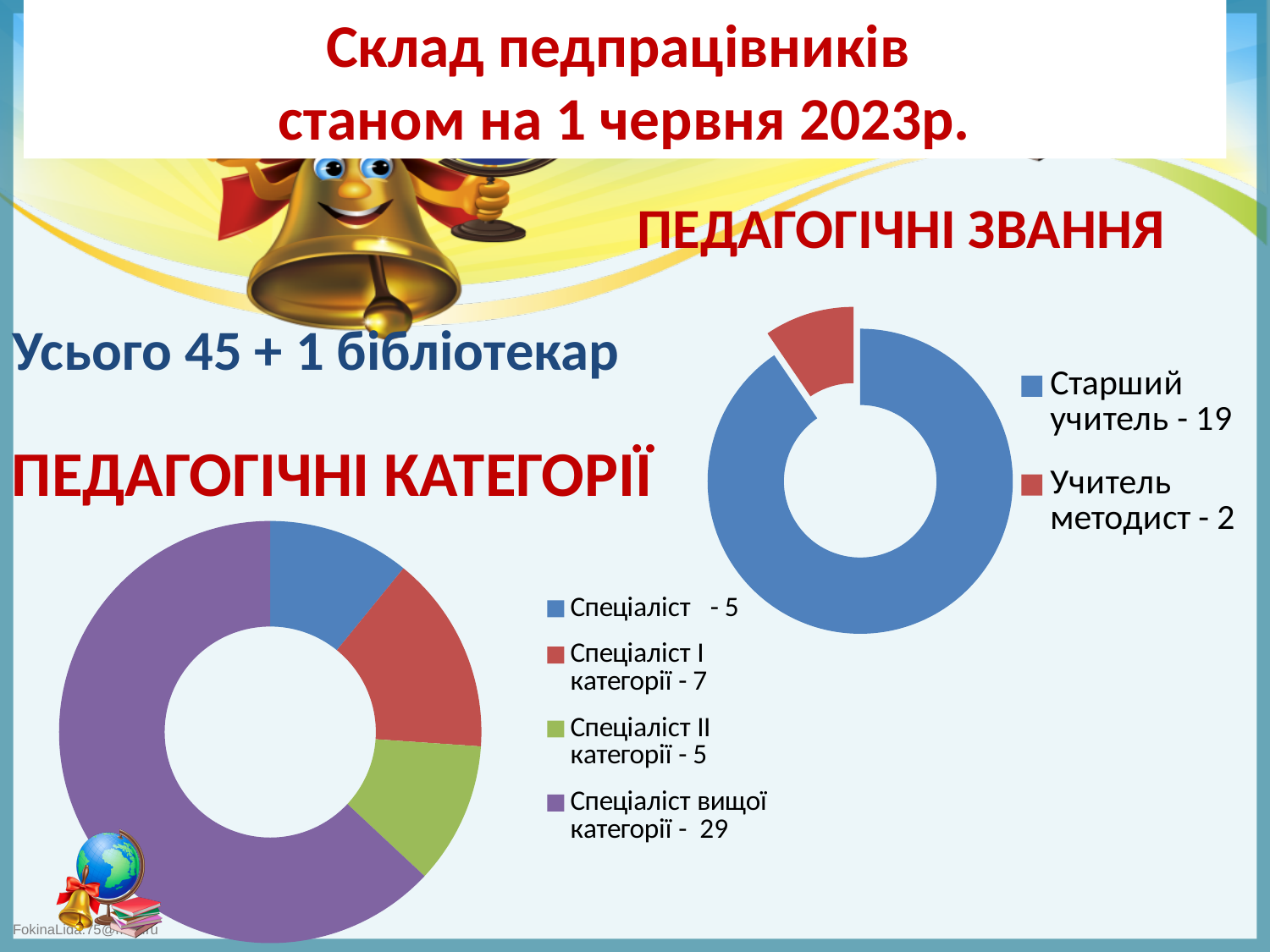
In the 'ПЕДАГОГІЧНІ КАТЕГОРІЇ' chart, what is the difference between 'Спеціаліст вищої категорії' and 'Спеціаліст І категорії'? 22 In the 'ПЕДАГОГІЧНІ КАТЕГОРІЇ' chart, what colour represents 'Спеціаліст вищої категорії'? Purple In the 'ПЕДАГОГІЧНІ ЗВАННЯ' chart on the right, how many teachers are 'Старший учитель'? 19 In the 'ПЕДАГОГІЧНІ КАТЕГОРІЇ' chart, which is larger: 'Спеціаліст І категорії' or 'Спеціаліст ІІ категорії'? Спеціаліст І категорії What kind of chart is the 'ПЕДАГОГІЧНІ КАТЕГОРІЇ' chart on the left of the slide? Doughnut chart In the 'ПЕДАГОГІЧНІ КАТЕГОРІЇ' chart, how many teachers are 'Спеціаліст вищої категорії'? 29 In the 'ПЕДАГОГІЧНІ ЗВАННЯ' chart, how many categories does the legend list? 2 In the 'ПЕДАГОГІЧНІ ЗВАННЯ' chart, what is the difference between 'Старший учитель' and 'Учитель методист'? 17 In the 'ПЕДАГОГІЧНІ КАТЕГОРІЇ' chart, what is the value for 'Спеціаліст І категорії'? 7 In the 'ПЕДАГОГІЧНІ ЗВАННЯ' chart, what is the value for 'Учитель методист'? 2 In the 'ПЕДАГОГІЧНІ КАТЕГОРІЇ' chart, how many categories does the legend list? 4 In the 'ПЕДАГОГІЧНІ КАТЕГОРІЇ' chart, which category has the largest value? Спеціаліст вищої категорії